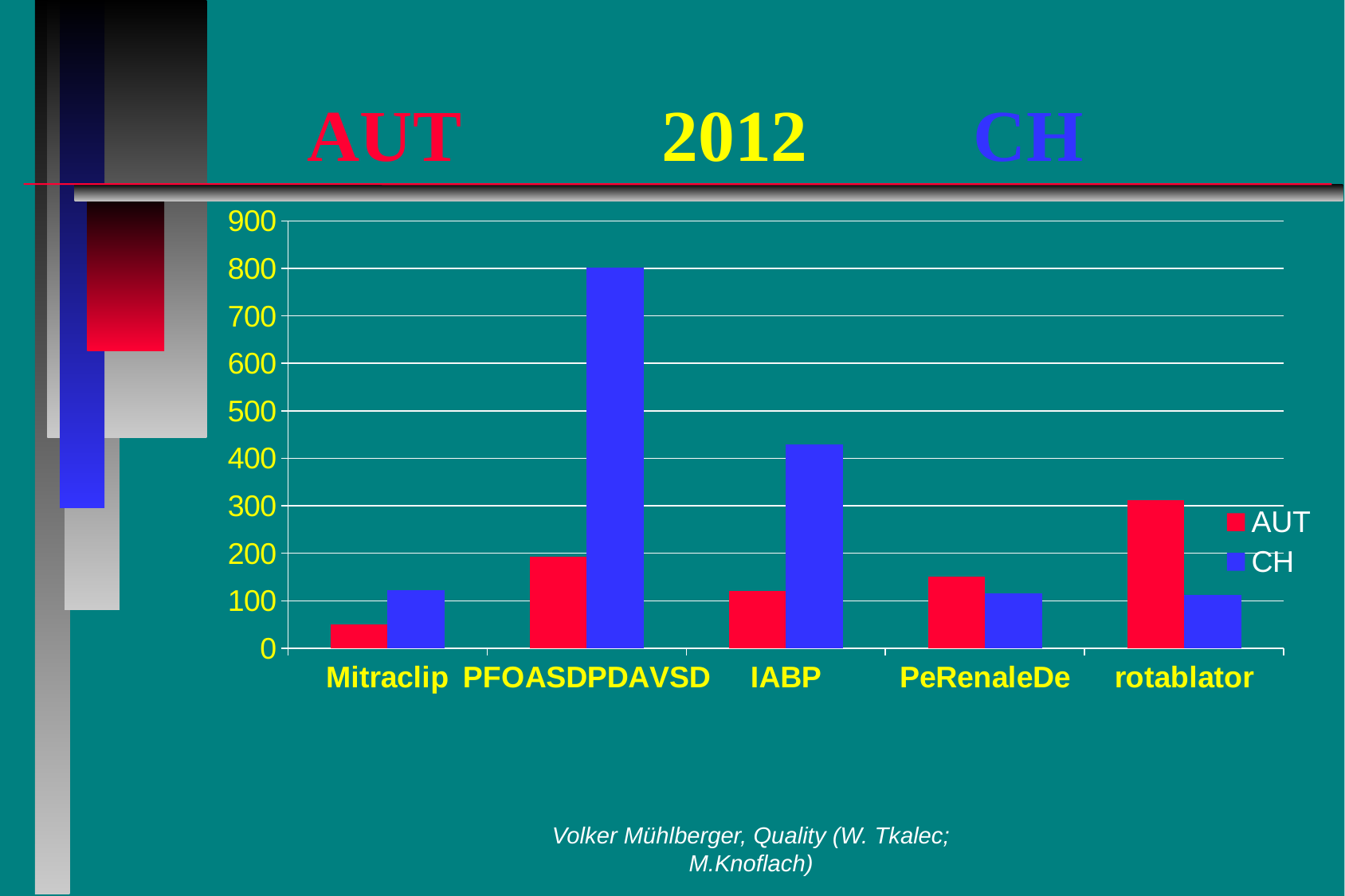
Is the CH value for PFOASDPDAVSD greater or less than 700? greater Is the CH value for IABP greater or less than 400? greater How many series does the legend list? 2 For IABP, which is larger, the AUT value or the CH value? CH Which colour represents the CH series in the legend? blue For rotablator, which is larger, the AUT value or the CH value? AUT How many categories are shown on the x axis? 5 Which category has the highest AUT value? rotablator Which category has the lowest AUT value? Mitraclip What kind of chart is shown on the slide? bar chart Is the AUT value for Mitraclip greater or less than 100? less Which category has the highest CH value? PFOASDPDAVSD